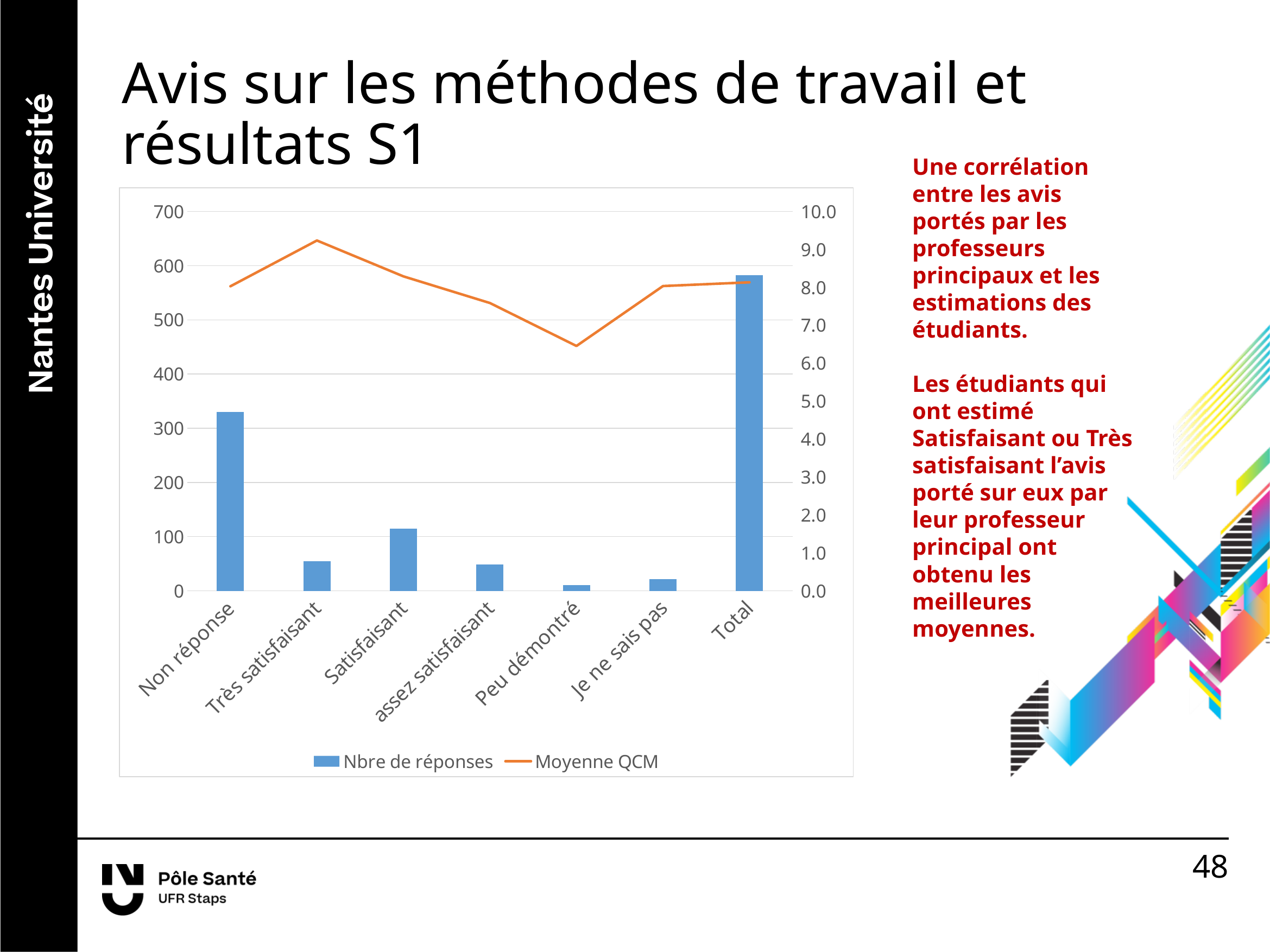
How many categories are shown on the x axis? 7 Which category has the highest Moyenne QCM on the line? Très satisfaisant Which category has the tallest bar for Nbre de réponses? Total Which category has the lowest Moyenne QCM on the line? Peu démontré How many series does the legend list? 2 Which category has the lowest bar for Nbre de réponses? Peu démontré Is the Moyenne QCM for Peu démontré greater or less than 7.0? less Is the Nbre de réponses for Satisfaisant greater or less than 100? greater Is the Nbre de réponses for Non réponse greater or less than 300? greater What are the two series named in the legend? Nbre de réponses and Moyenne QCM What kind of chart is shown on the slide? A combined bar and line chart Which has more Nbre de réponses, Satisfaisant or Très satisfaisant? Satisfaisant